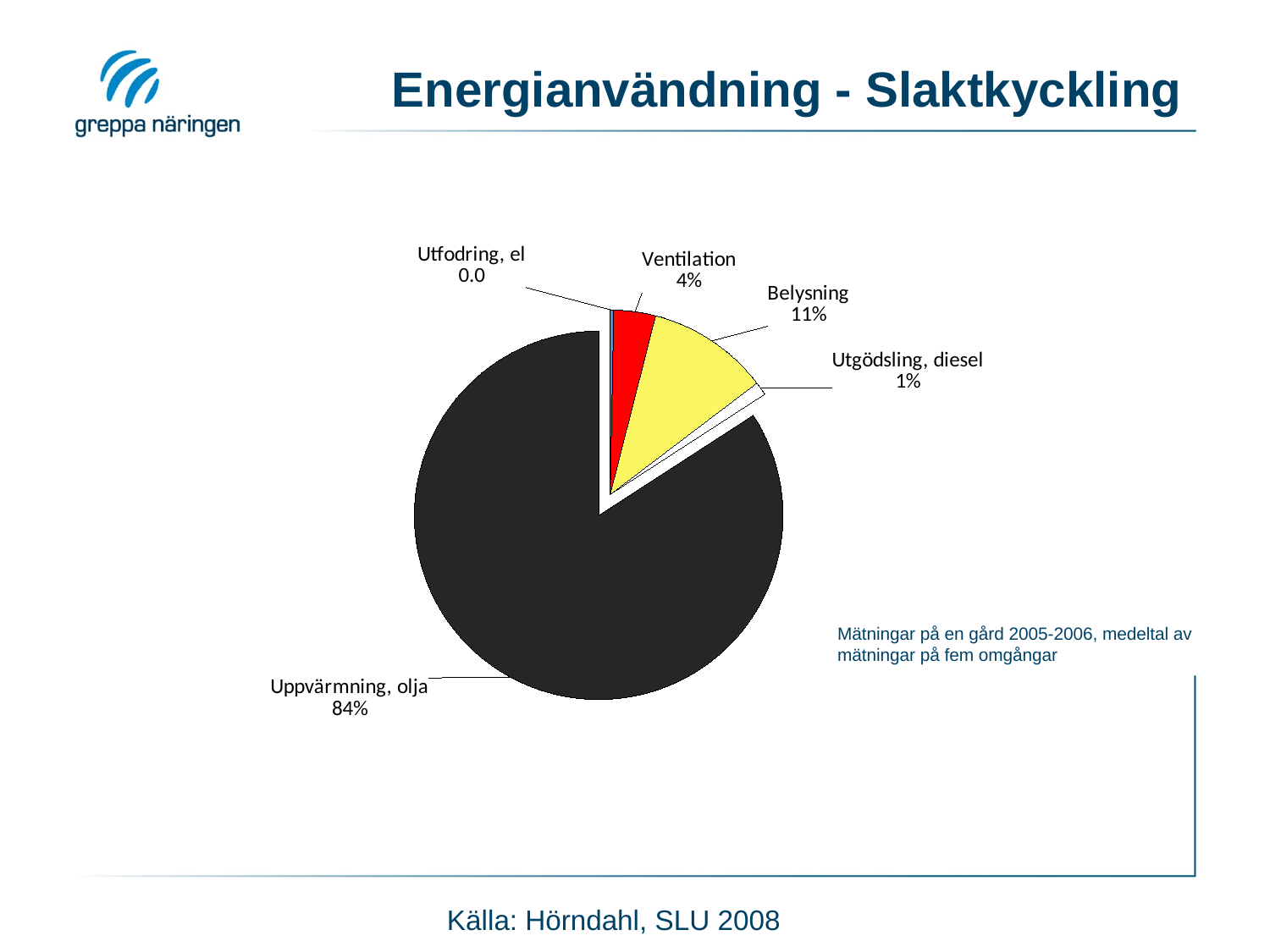
Which category has the smallest share of the pie? Utfodring, el Which category has the largest share of the pie? Uppvärmning, olja What is the difference in percentage points between Belysning and Ventilation? 7 Which is larger, the share for Ventilation or the share for Utgödsling, diesel? Ventilation What value is shown for Utfodring, el? 0.0 What share of energy use does Ventilation account for? 4% How many categories are shown in the pie chart? 5 What kind of chart is shown on the slide? Pie chart What share of energy use does Utgödsling, diesel account for? 1% What is the title of the slide? Energianvändning - Slaktkyckling What share of energy use does Belysning account for? 11% What share of energy use does Uppvärmning, olja account for? 84%